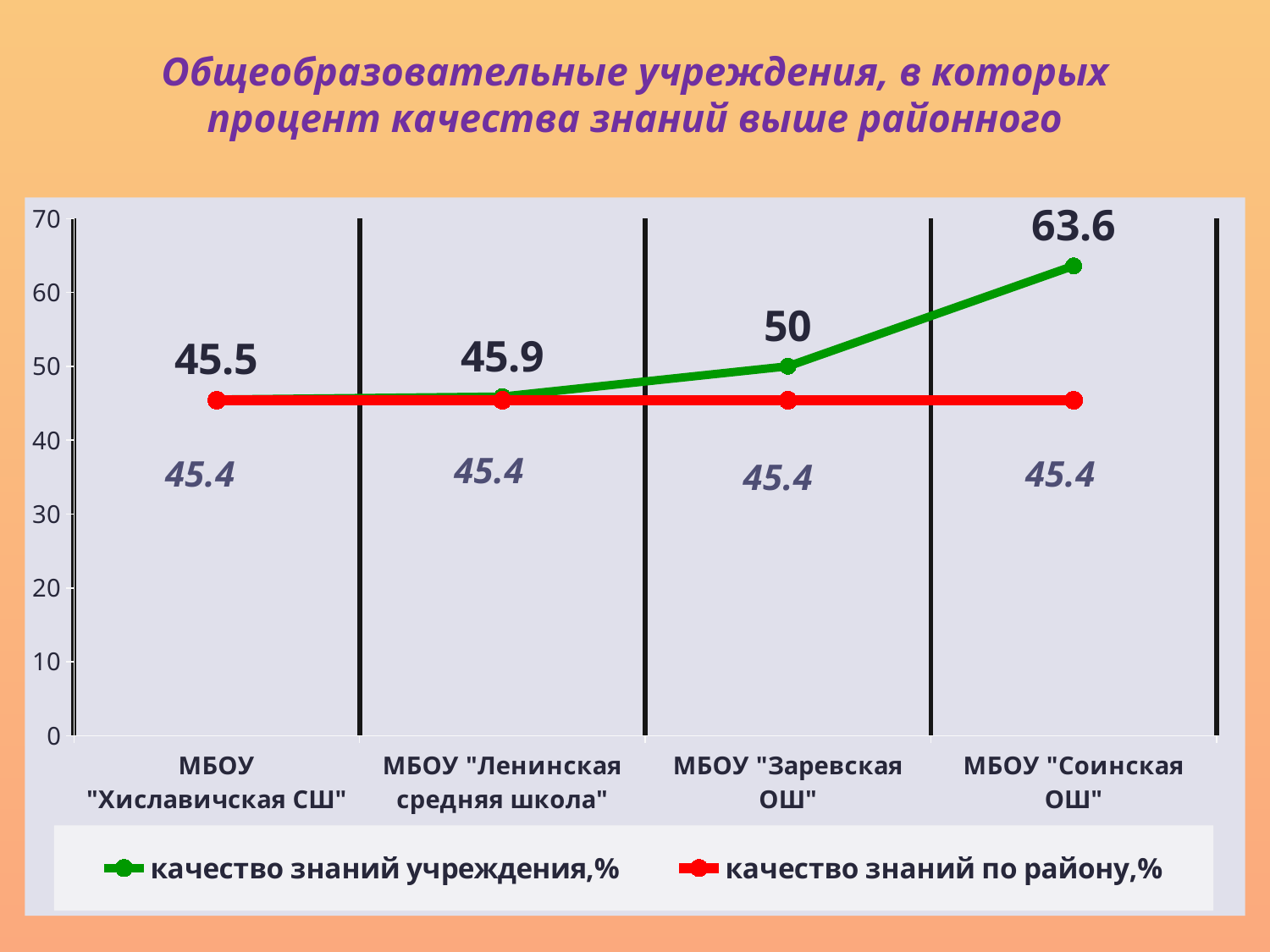
What is the value of "качество знаний учреждения,%" for МБОУ "Соинская ОШ"? 63.6 How many schools are shown on the x axis? 4 What is the value of "качество знаний по району,%" for МБОУ "Ленинская средняя школа"? 45.4 Which school has the lowest value of "качество знаний учреждения,%"? МБОУ "Хиславичская СШ" Which school has the highest value of "качество знаний учреждения,%"? МБОУ "Соинская ОШ" How many series does the legend list? 2 Does the "качество знаний учреждения,%" line rise or fall from left to right? rise What is the value of "качество знаний учреждения,%" for МБОУ "Хиславичская СШ"? 45.5 What is the value of "качество знаний учреждения,%" for МБОУ "Заревская ОШ"? 50 What is the difference between "качество знаний учреждения,%" for МБОУ "Соинская ОШ" and МБОУ "Заревская ОШ"? 13.6 What type of chart is shown on the slide? line chart Which is larger: "качество знаний учреждения,%" for МБОУ "Заревская ОШ" or for МБОУ "Ленинская средняя школа"? МБОУ "Заревская ОШ"